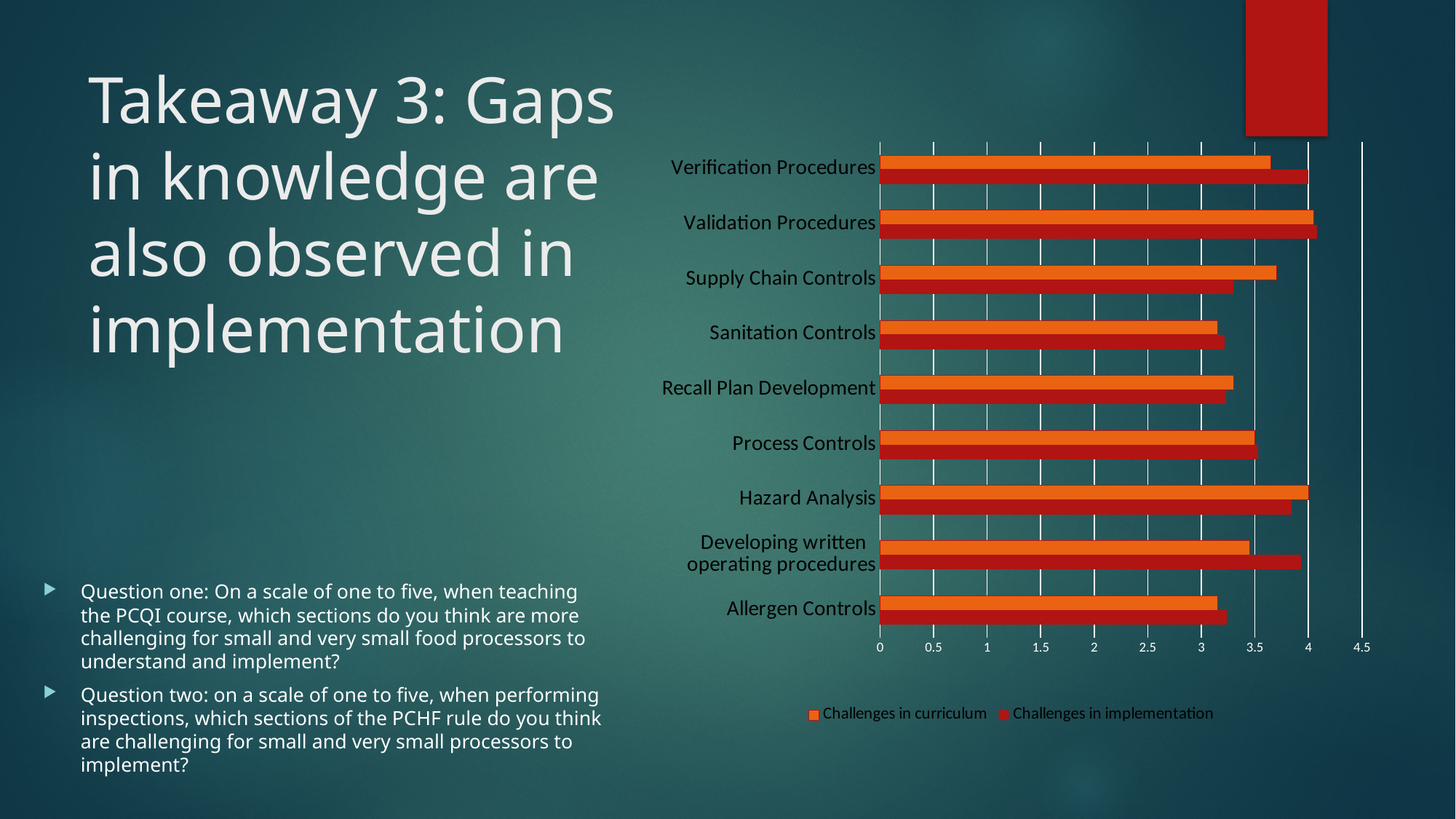
What kind of chart is shown on the slide? Bar chart Is the Challenges in implementation value for Developing written operating procedures greater or less than 3.5? greater For Verification Procedures, which is larger: Challenges in curriculum or Challenges in implementation? Challenges in implementation How many series does the chart legend list? 2 For Supply Chain Controls, which is larger: Challenges in curriculum or Challenges in implementation? Challenges in curriculum Is the Challenges in curriculum value for Allergen Controls greater or less than 3.5? less Is the Challenges in curriculum value for Verification Procedures greater or less than 3.5? greater Which series is drawn in the darker red colour? Challenges in implementation For Developing written operating procedures, which is larger: Challenges in curriculum or Challenges in implementation? Challenges in implementation How many categories are plotted on the chart? 9 What are the two series named in the chart legend? Challenges in curriculum; Challenges in implementation